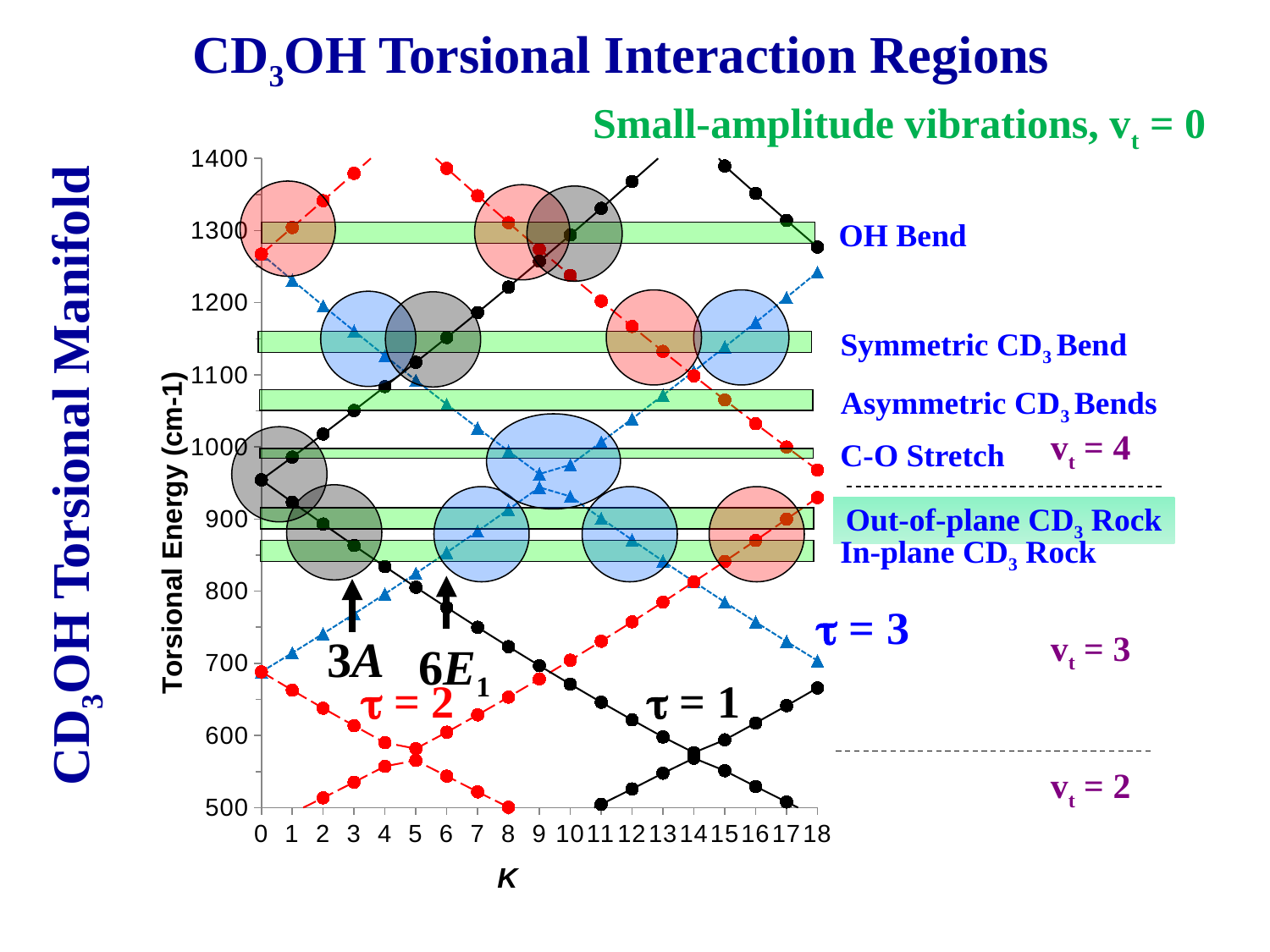
Is the value of the τ = 1 series at K = 14 greater or less than 600? less What kind of chart is shown on the slide? line chart How many tick values are shown on the horizontal axis? 19 Is the value of the τ = 2 series at K = 18 greater or less than 900? greater What is the label of the vertical axis? Torsional Energy (cm-1) What is the label of the horizontal axis? κ Which of the labelled vibration bands lies at the highest torsional energy? OH Bend Which of the labelled vibration bands lies at the lowest torsional energy? In-plane CD3 Rock Is the value of the τ = 3 series at K = 3 greater or less than 800? less